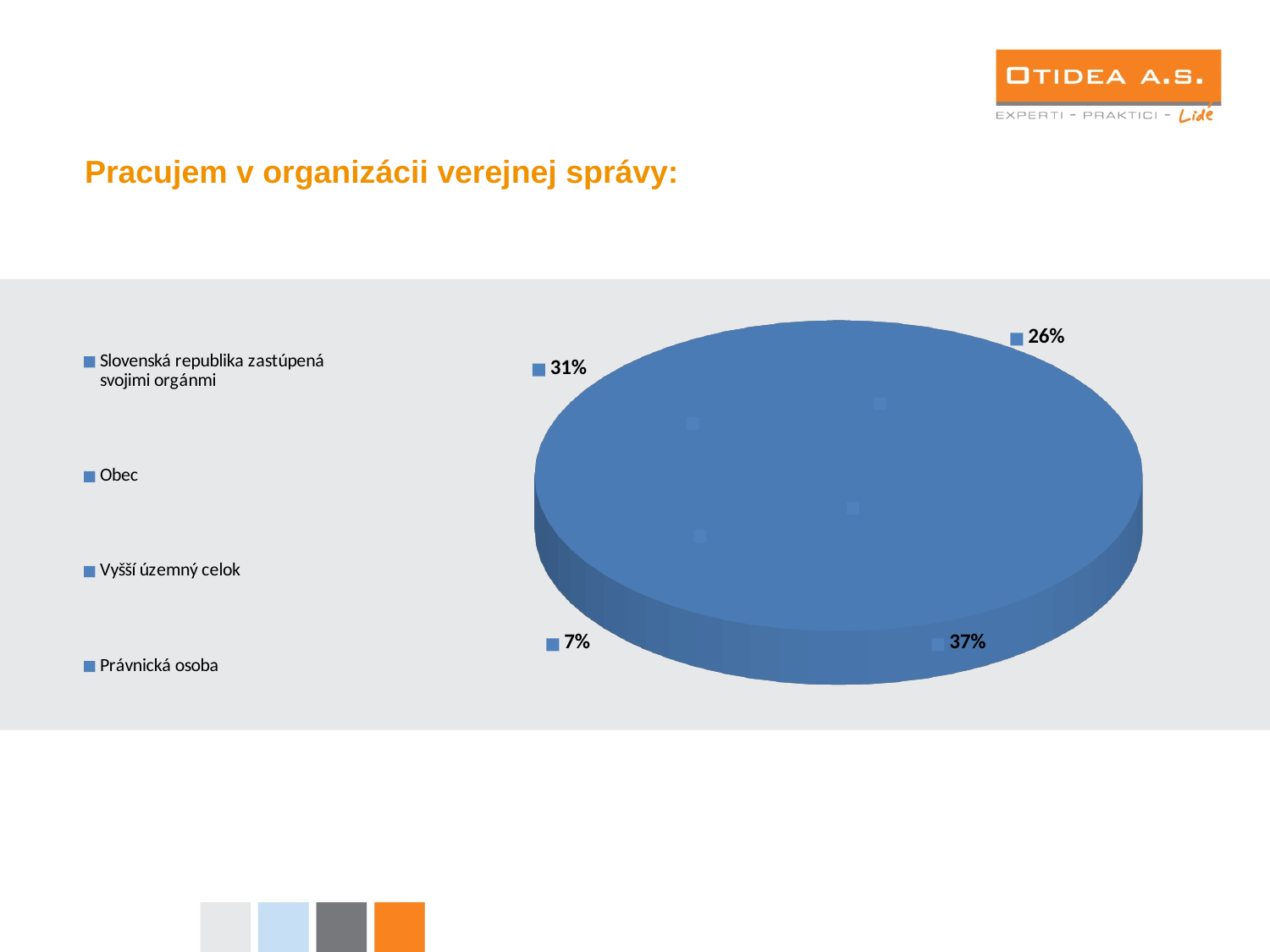
What is the largest percentage shown as a data label on the pie chart? 37% What is the smallest percentage shown as a data label on the pie chart? 7% What is the title of the slide containing the pie chart? Pracujem v organizácii verejnej správy: Which is larger, the slice labelled 31% or the slice labelled 26%? The slice labelled 31% Does any single slice of the pie chart account for more than half of the pie? No How many categories does the legend of the pie chart list? 4 What is the difference between the largest and smallest percentages labelled on the pie chart? 30 percentage points What is the first entry listed in the legend of the pie chart? Slovenská republika zastúpená svojimi orgánmi What kind of chart is shown on the slide? Pie chart